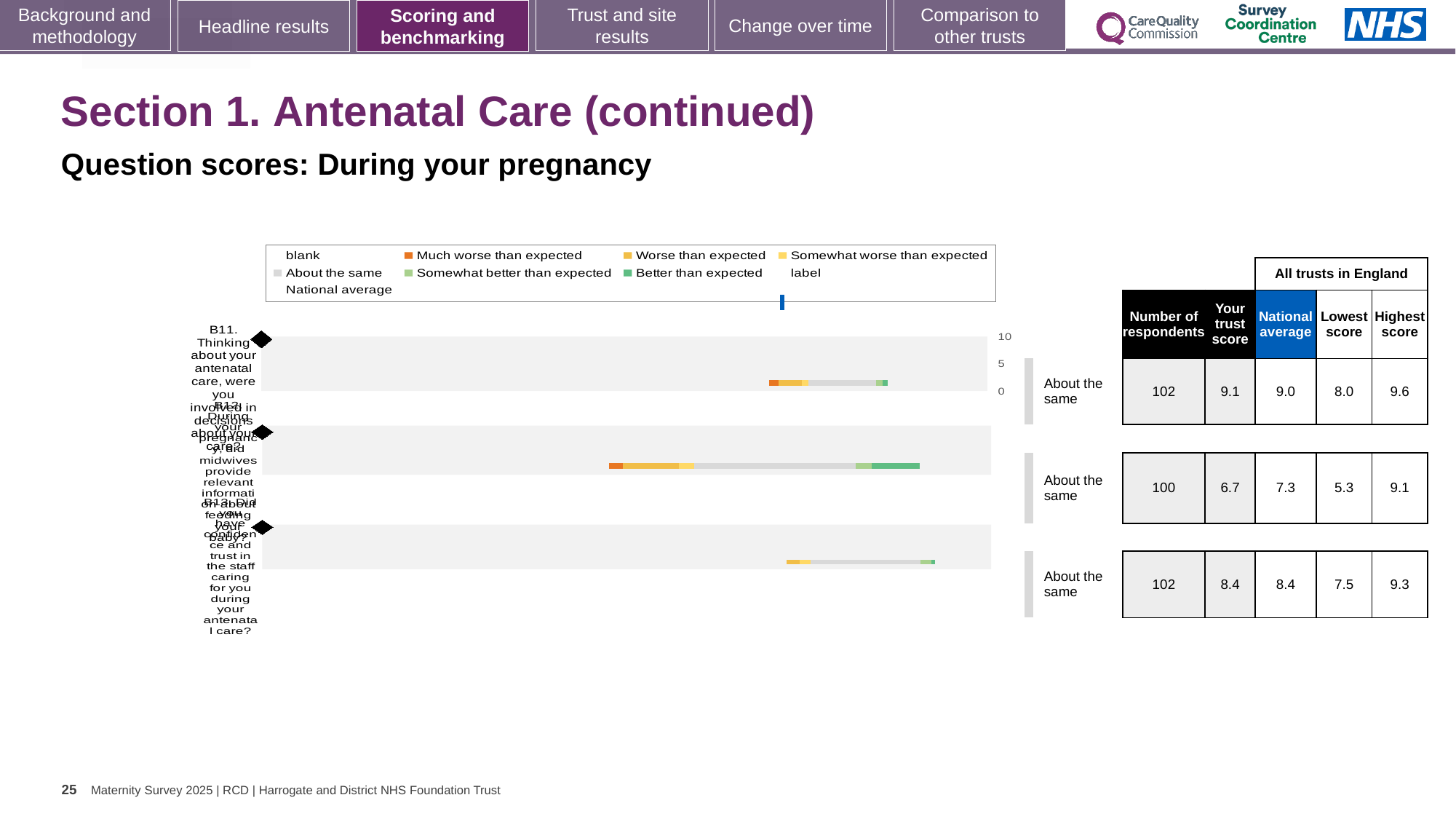
In the table beside the chart, what is the highest score in England for B13 (confidence and trust in staff during antenatal care)? 9.3 In the table beside the chart, what is the national average for B12 (midwives provide relevant information about feeding your baby)? 7.3 Which question has the highest trust score in the table beside the chart? B11 In the table beside the chart, what is the trust score for B11 (involved in decisions about your antenatal care)? 9.1 How many entries does the chart legend list? 9 For B12, which is larger in the table beside the chart: the trust score or the national average? national average What is the subtitle above the chart? Question scores: During your pregnancy In the table beside the chart, how many respondents answered B12? 100 What kind of chart is shown on the slide? bar chart How many questions (categories) are plotted in the chart? 3 Which question has the lowest trust score in the table beside the chart? B12 What is the difference between the highest score and the lowest score for B12 in the table beside the chart? 3.8